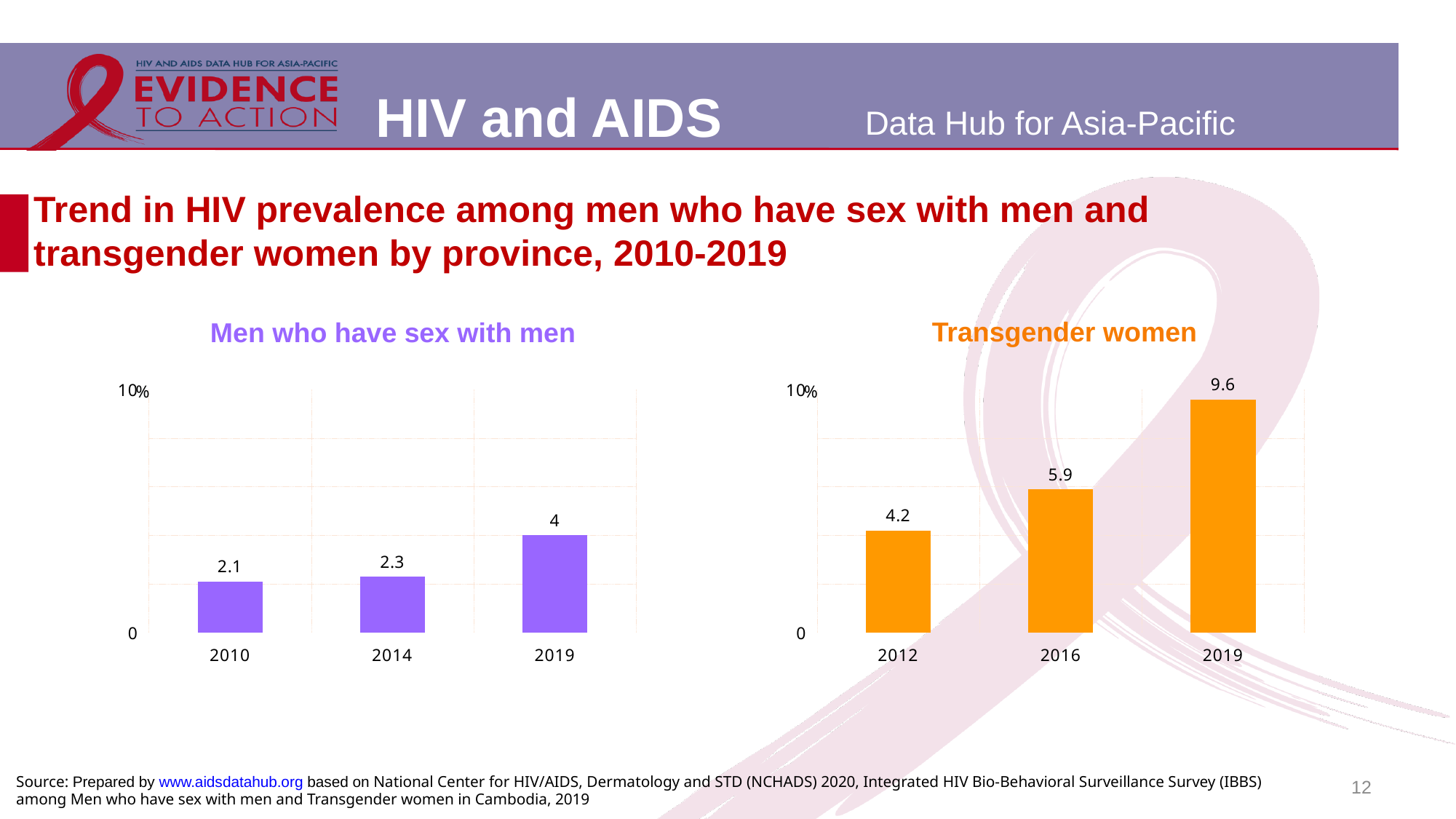
In the 'Men who have sex with men' chart, what is the difference between the 2019 and 2014 values? 1.7 In the 'Men who have sex with men' chart, which year has the lowest value? 2010 In the 'Transgender women' chart, what is the difference between the 2019 and 2012 values? 5.4 In the 'Transgender women' chart, what is the value for 2016? 5.9 In the 'Transgender women' chart, which year has the highest value? 2019 In the 'Men who have sex with men' chart, what is the value for 2019? 4 In the 'Transgender women' chart, do the values rise or fall from 2012 to 2019? Rise What type of chart is the 'Men who have sex with men' chart? Bar chart What colour are the bars in the 'Transgender women' chart? Orange How many bars are in the 'Transgender women' chart? 3 Which is larger: the 2019 value in the 'Transgender women' chart or the 2019 value in the 'Men who have sex with men' chart? Transgender women In the 'Men who have sex with men' chart, what is the value for 2010? 2.1